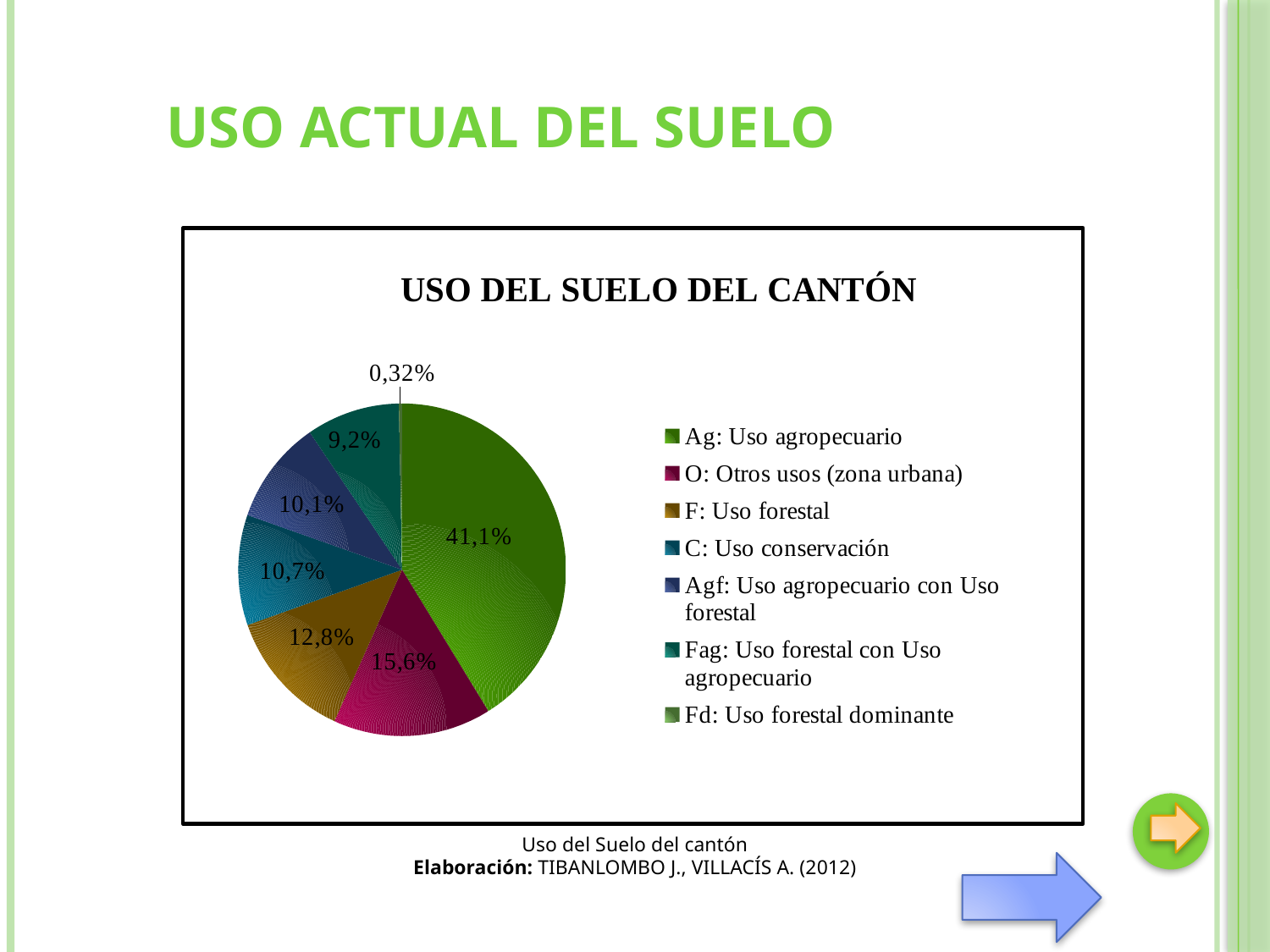
What is the title of the chart? USO DEL SUELO DEL CANTÓN How many categories does the legend of the pie chart list? 7 Which category has the smallest slice of the pie? Fd: Uso forestal dominante What share of the pie does O: Otros usos (zona urbana) have? 15,6% What share of the pie does F: Uso forestal have? 12,8% What share of the pie does C: Uso conservación have? 10,7% Which is larger, the slice for Agf: Uso agropecuario con Uso forestal or the slice for Fag: Uso forestal con Uso agropecuario? Agf: Uso agropecuario con Uso forestal Which category has the largest slice of the pie? Ag: Uso agropecuario What kind of chart is shown on the slide? Pie chart What is the difference in percentage points between Ag: Uso agropecuario and O: Otros usos (zona urbana)? 25,5